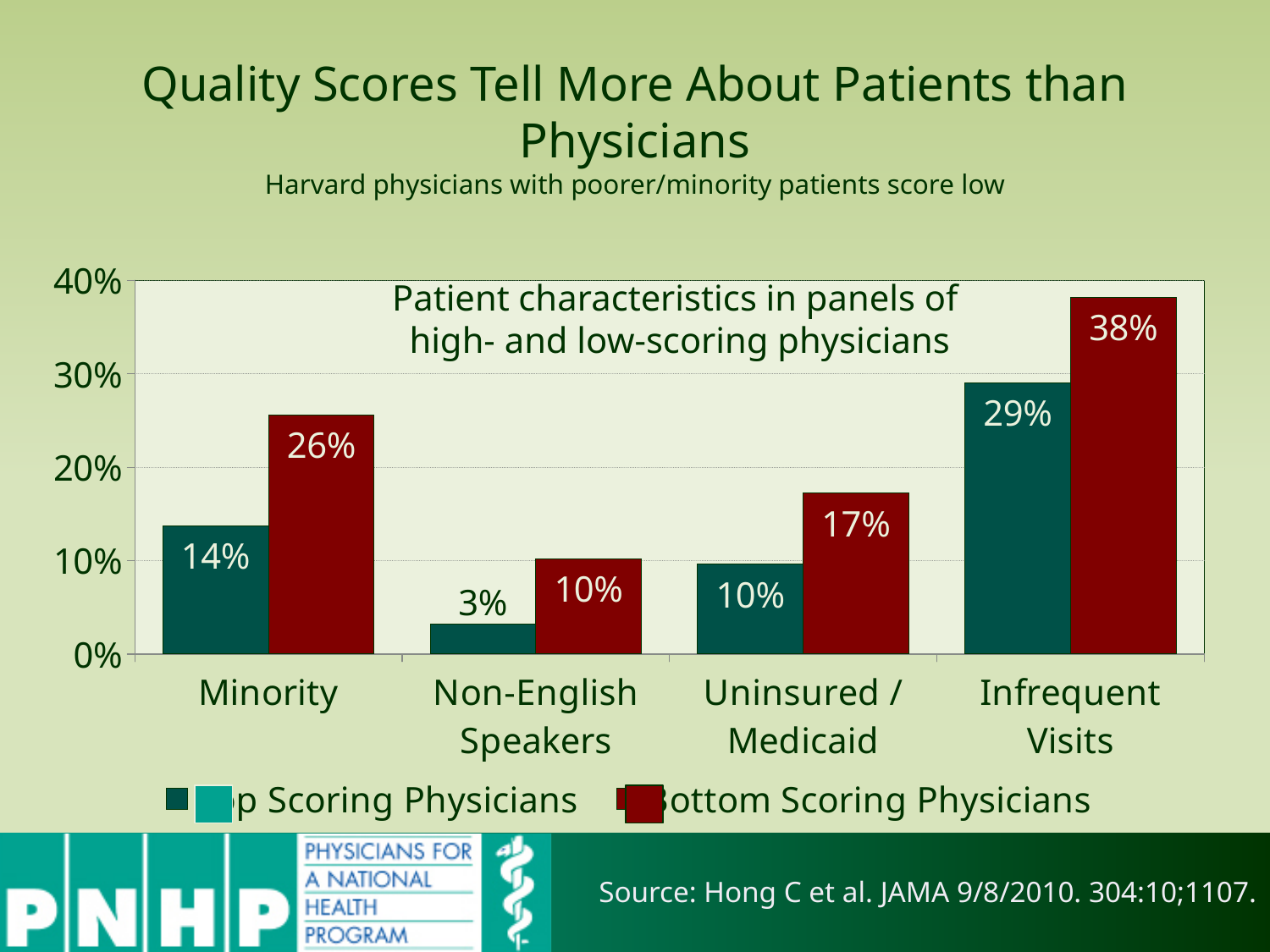
What is the difference between Bottom Scoring Physicians and Top Scoring Physicians in the Minority category? 12% Which is larger in the Uninsured / Medicaid category: Top Scoring Physicians or Bottom Scoring Physicians? Bottom Scoring Physicians Which category has the lowest value for Top Scoring Physicians? Non-English Speakers Which category has the highest value for Bottom Scoring Physicians? Infrequent Visits What is the value for Top Scoring Physicians in the Non-English Speakers category? 3% How many series does the legend list? 2 What is the value for Bottom Scoring Physicians in the Uninsured / Medicaid category? 17% What is the value for Top Scoring Physicians in the Minority category? 14% What kind of chart is shown on the slide? Bar chart What is the title printed inside the chart area? Patient characteristics in panels of high- and low-scoring physicians What is the value for Bottom Scoring Physicians in the Infrequent Visits category? 38% How many categories are shown on the x axis? 4